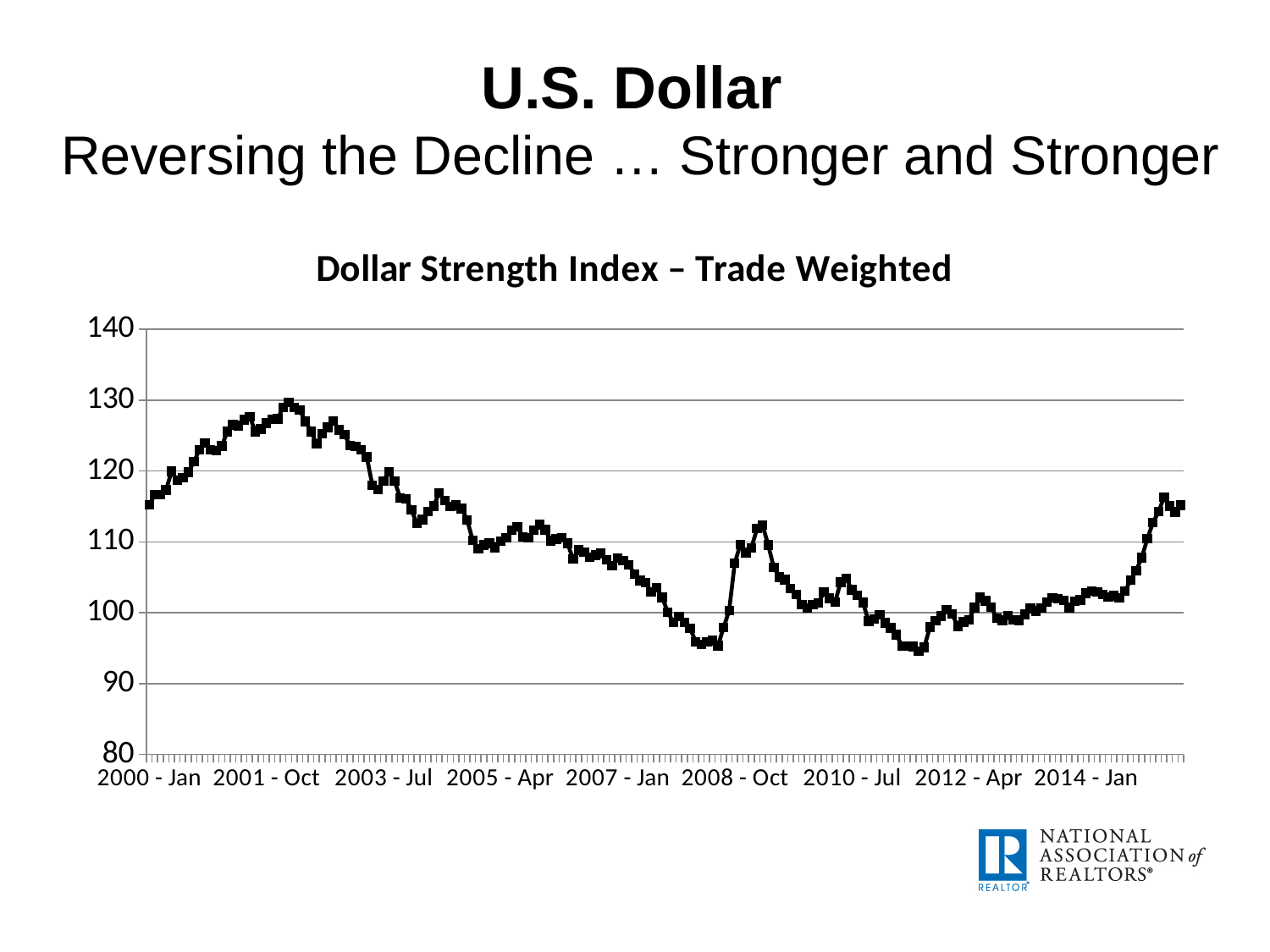
Is the value of the index at 2003 - Jul greater or less than 110? greater Is the value of the index at 2007 - Jan greater or less than 110? less Does the index generally rise or fall between 2001 - Oct and 2008 - Oct? fall Is the value of the index at 2014 - Jan greater or less than 110? less What kind of chart is shown on the slide? line chart Does the index rise or fall from 2014 - Jan to the end of the series? rise What is the title of the chart? Dollar Strength Index – Trade Weighted What is the first label on the x axis of the chart? 2000 - Jan